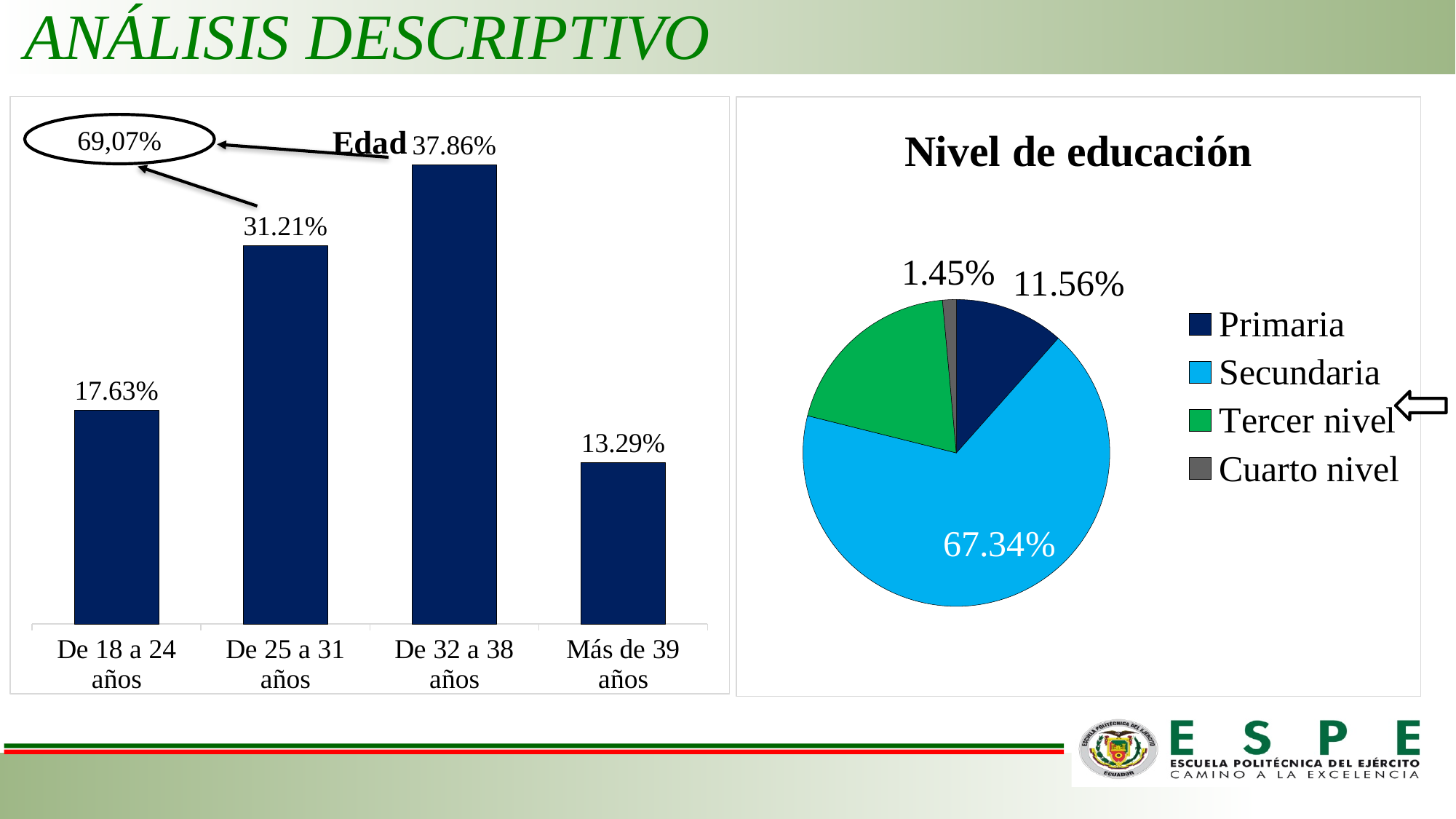
In the 'Nivel de educación' chart, what is the value for 'Primaria'? 11.56% How many age categories are shown in the 'Edad' chart? 4 In the 'Edad' chart, which is larger: the value for 'De 25 a 31 años' or 'De 18 a 24 años'? De 25 a 31 años What kind of chart is the 'Edad' chart? Bar chart In the 'Nivel de educación' chart, what share of the pie is 'Secundaria'? 67.34% In the 'Edad' chart, what is the value for 'De 25 a 31 años'? 31.21% In the 'Edad' chart, which age group has the lowest value? Más de 39 años In the 'Edad' chart, which age group has the highest value? De 32 a 38 años How many categories does the legend of the 'Nivel de educación' chart list? 4 In the 'Edad' chart, what is the difference between the values for 'De 32 a 38 años' and 'De 18 a 24 años'? 20.23% In the 'Nivel de educación' chart, which category has the smallest slice? Cuarto nivel In the 'Edad' chart, what is the value for 'Más de 39 años'? 13.29%